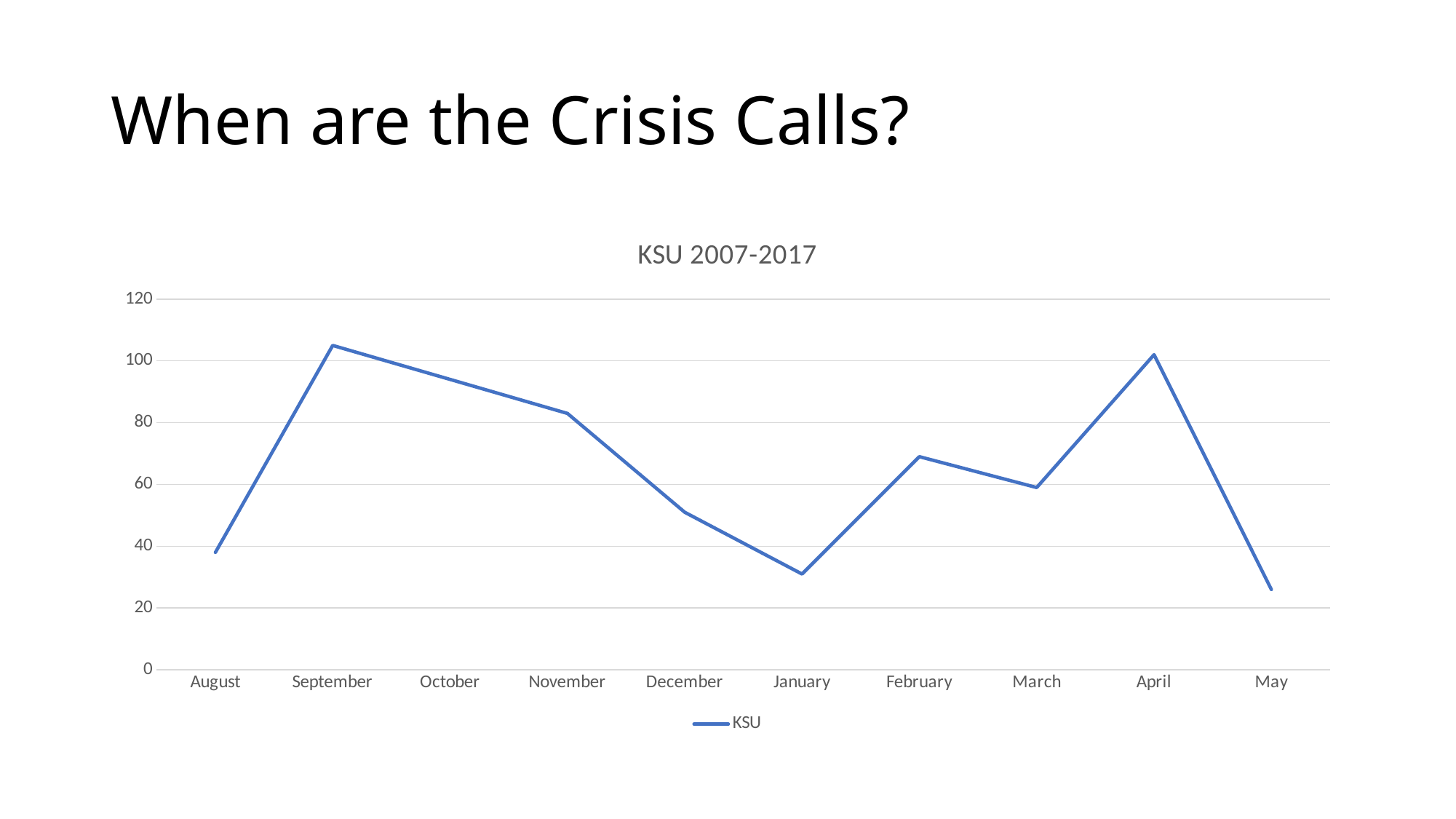
How many months are plotted along the x axis? 10 Is the value for December greater or less than 60? less Is the value for September greater or less than 100? greater What kind of chart is shown on the slide? line chart How many series does the legend list? 1 Which is larger, the value for September or the value for August? September Which is larger, the value for April or the value for May? April Is the value for February greater or less than 60? greater What is the title of the chart? KSU 2007-2017 Do the values rise or fall from September to January? fall